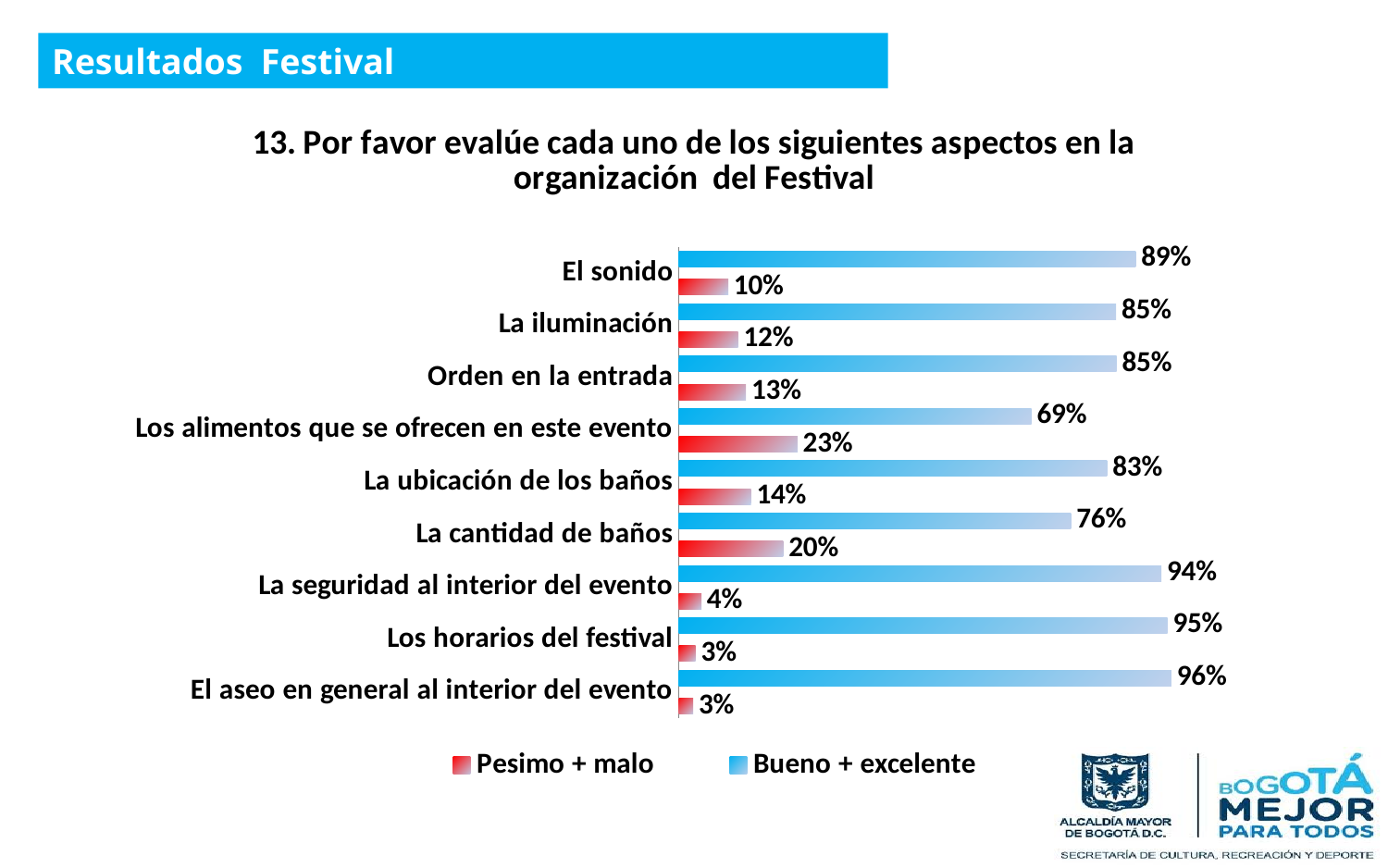
What is the 'Bueno + excelente' value for La cantidad de baños? 76% What type of chart is shown on the slide? Bar chart Which series is shown in red in the legend? Pesimo + malo What is the difference between the 'Bueno + excelente' values for La seguridad al interior del evento and La ubicación de los baños? 11% Which category has the lowest 'Bueno + excelente' value? Los alimentos que se ofrecen en este evento Which category has the highest 'Bueno + excelente' value? El aseo en general al interior del evento Which is larger: the 'Pesimo + malo' value for La cantidad de baños or for La ubicación de los baños? La cantidad de baños How many categories are shown in the chart? 9 How many series does the legend list? 2 What is the 'Bueno + excelente' value for El sonido? 89% Which category has the highest 'Pesimo + malo' value? Los alimentos que se ofrecen en este evento What is the 'Pesimo + malo' value for Los alimentos que se ofrecen en este evento? 23%